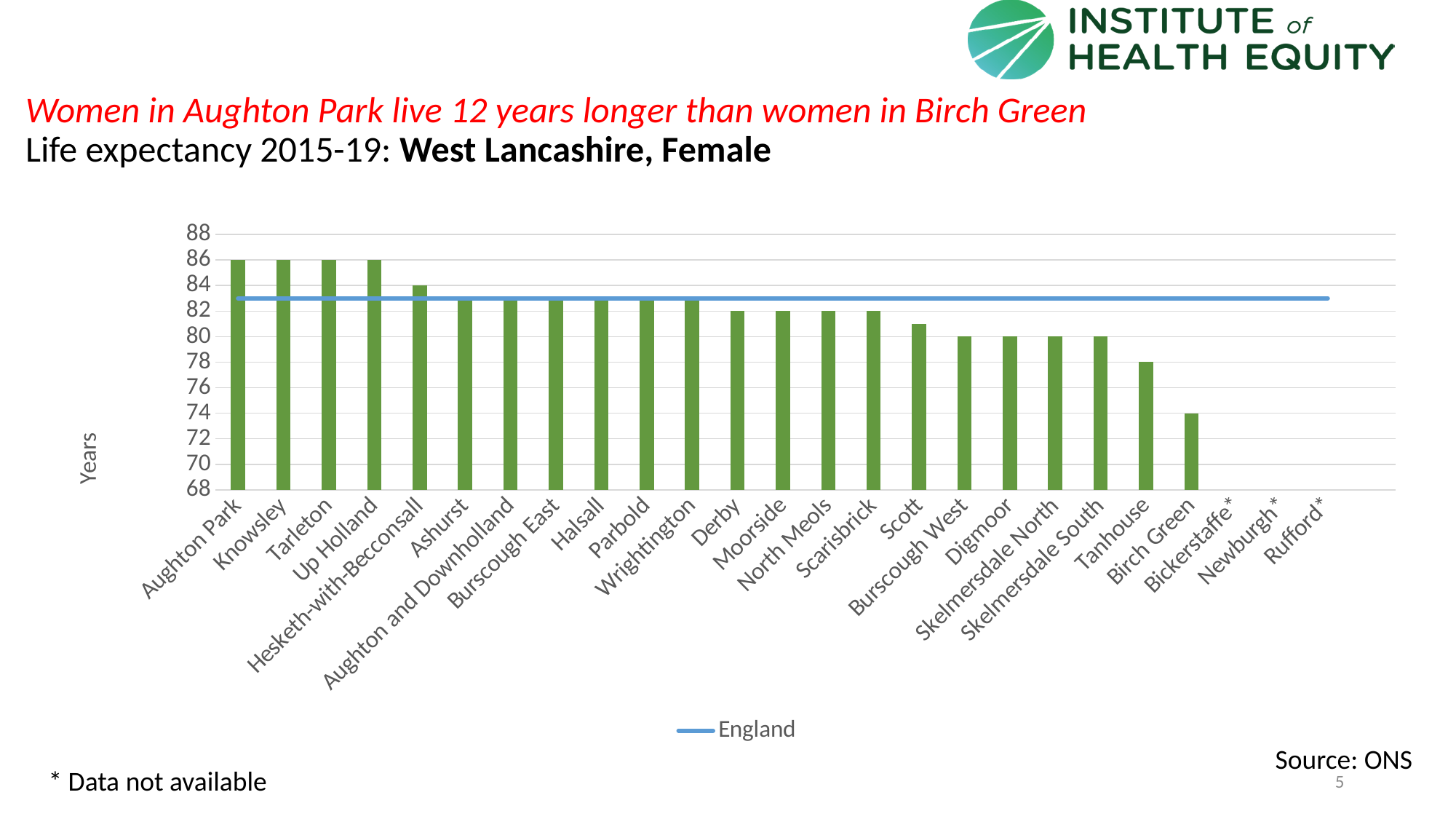
What is the difference in female life expectancy between Aughton Park and Birch Green? 12 What does the blue horizontal line on the chart represent? England Is the value for Scott greater or less than 80? greater What is the female life expectancy for Aughton Park? 86 Which ward has the lowest female life expectancy shown? Birch Green What kind of chart is shown on the slide? Bar chart What is the female life expectancy for Birch Green? 74 Is the value for Ashurst greater or less than 84? less Which has the higher female life expectancy, Tanhouse or Birch Green? Tanhouse What is the female life expectancy for Tanhouse? 78 What is the female life expectancy for Hesketh-with-Becconsall? 84 How many wards are marked with an asterisk as having no data available? 3